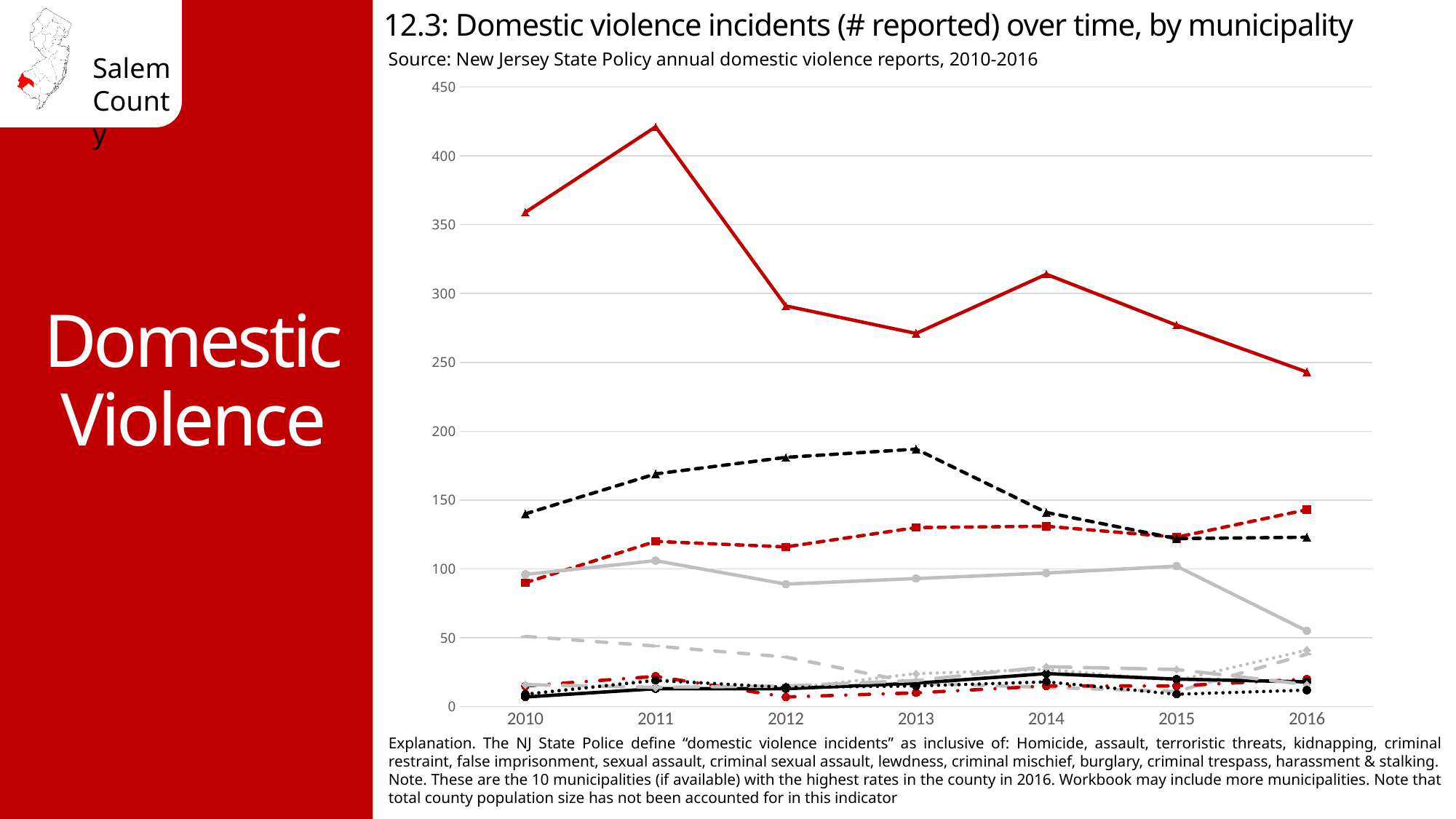
Does the solid red line rise or fall from 2014 to 2016? fall In which year does the solid red line reach its highest value? 2011 In which year does the solid red line reach its lowest value? 2016 Is the value of the solid red line in 2011 greater or less than 400? greater How many years are plotted along the x axis? 7 Is the value of the solid red line in 2016 greater or less than 250? less What is the title of the chart? 12.3: Domestic violence incidents (# reported) over time, by municipality In 2016, which is higher: the red dashed line or the black dashed line? the red dashed line Is the value of the black dashed line in 2010 greater or less than 150? less In which year does the black dashed line reach its highest value? 2013 What kind of chart is shown on the slide? line chart